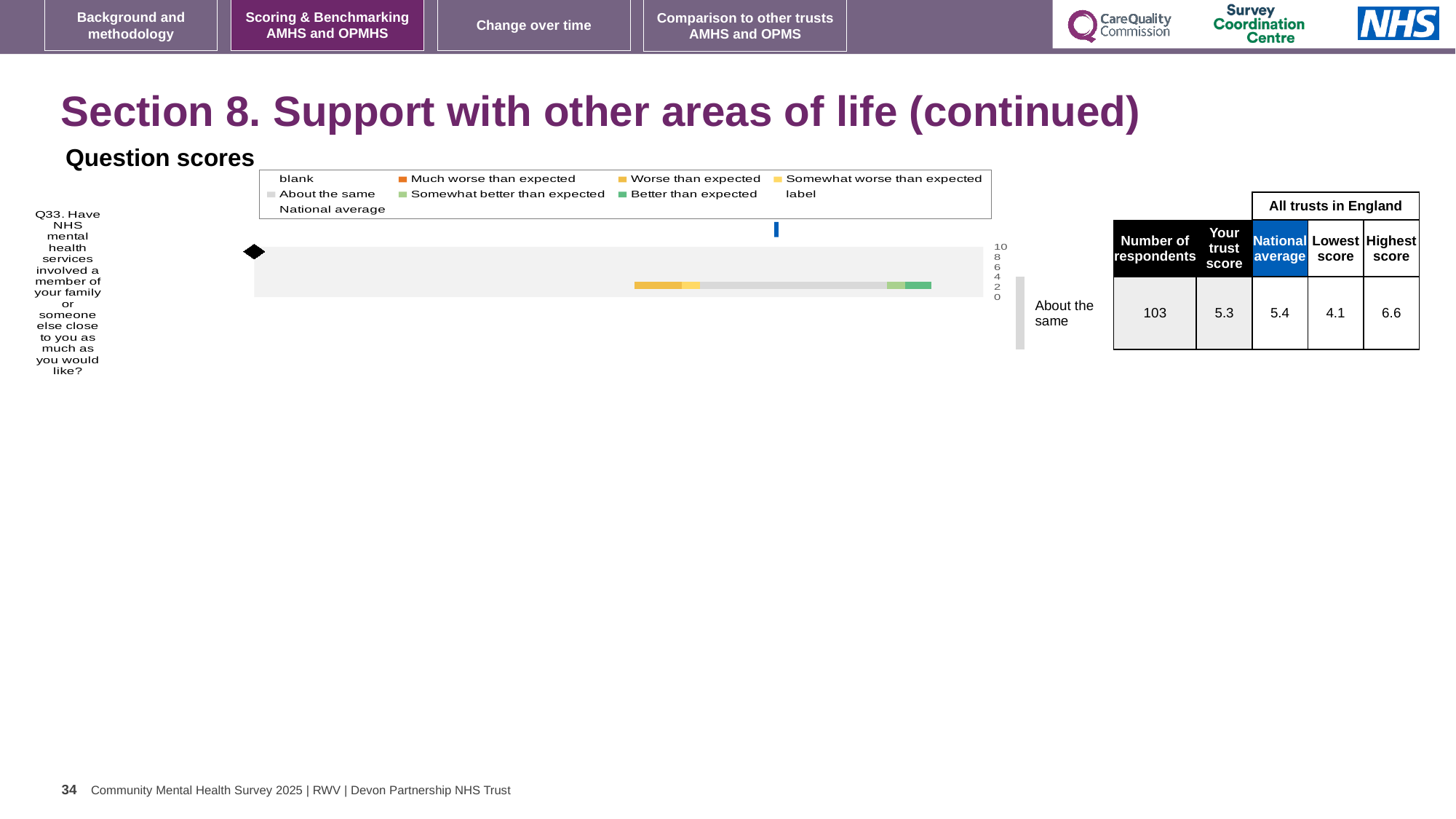
Which legend entry in the Question scores chart is shown in orange? Much worse than expected For Q33, what is the difference between the highest and lowest scores among all trusts in England? 2.5 How many questions are plotted in the Question scores chart? 1 What is the lowest score among all trusts in England for Q33? 4.1 What is the national average score for Q33? 5.4 For Q33, which is larger: the trust's score or the national average? National average Which question is plotted in the Question scores chart? Q33. Have NHS mental health services involved a member of your family or someone else close to you as much as you would like? What is the trust's score for Q33? 5.3 What benchmark category is shown next to the bar for Q33? About the same What is the number of respondents for Q33? 103 What kind of chart is shown under 'Question scores'? bar chart What is the highest score among all trusts in England for Q33? 6.6